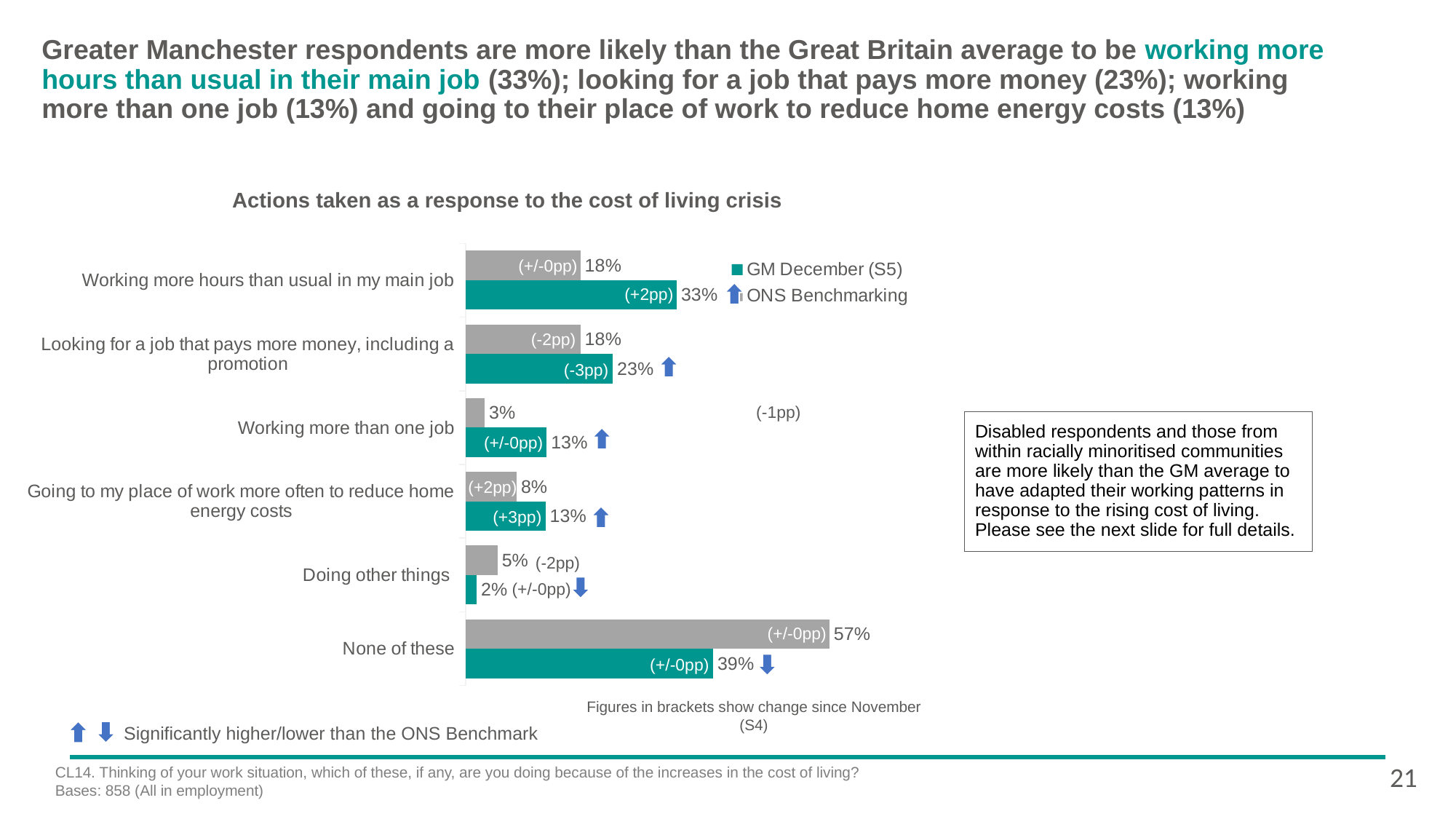
What is the GM December (S5) value for 'Working more hours than usual in my main job'? 33% What is the GM December (S5) value for 'Doing other things'? 2% What is the ONS Benchmarking value for 'Working more than one job'? 3% What is the ONS Benchmarking value for 'None of these'? 57% What is the title of the chart? Actions taken as a response to the cost of living crisis Which category has the highest GM December (S5) value? None of these For 'None of these', which is larger: the GM December (S5) value or the ONS Benchmarking value? ONS Benchmarking How many series does the legend list? 2 What type of chart is shown on the slide? Bar chart What is the difference between the GM December (S5) and ONS Benchmarking values for 'Working more hours than usual in my main job'? 15 percentage points How many categories are shown in the chart? 6 Which category has the lowest ONS Benchmarking value? Working more than one job